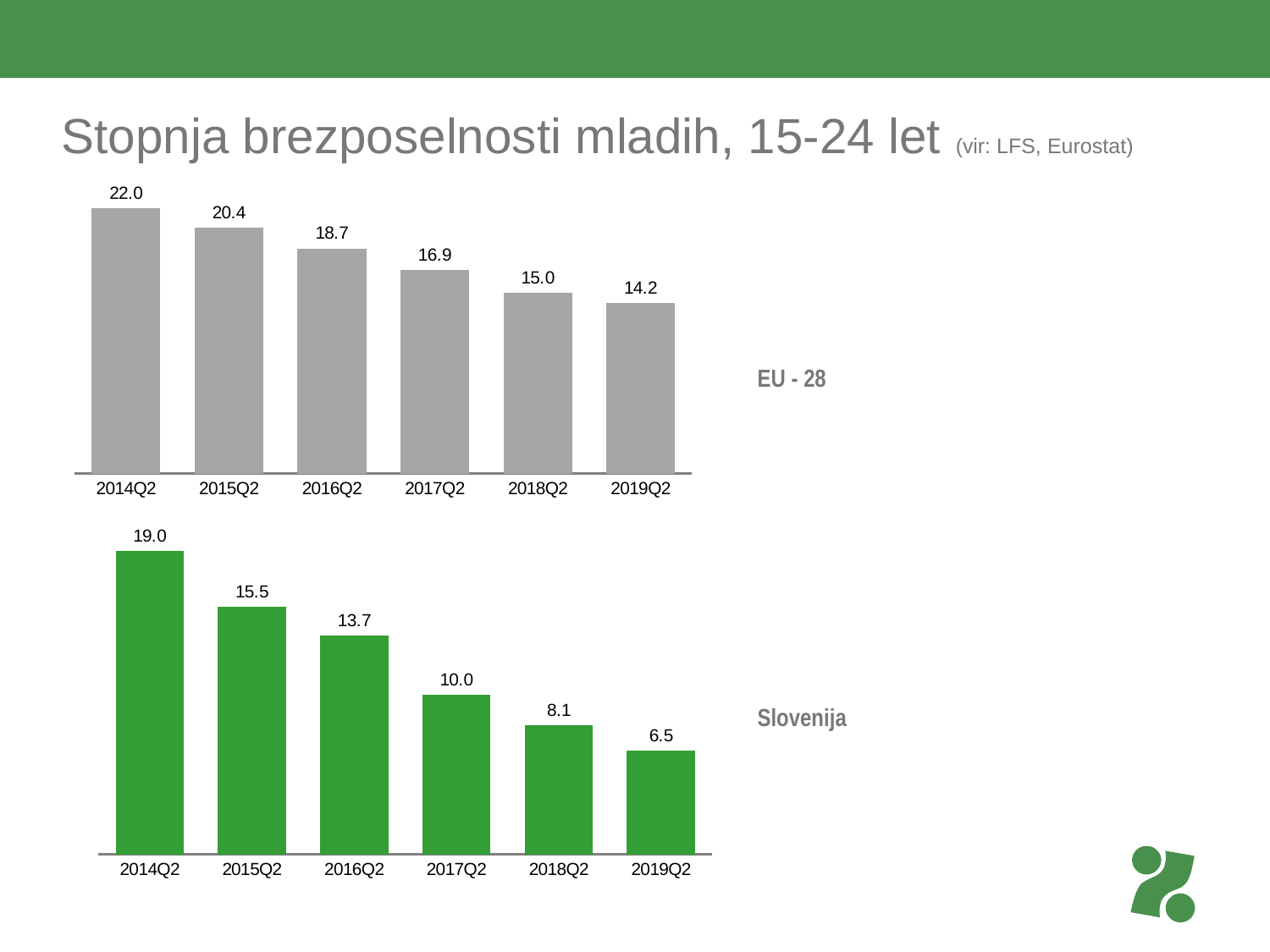
In the EU - 28 chart, what is the value for 2014Q2? 22.0 In the EU - 28 chart, what is the value for 2017Q2? 16.9 In the EU - 28 chart, what is the difference between the values for 2015Q2 and 2016Q2? 1.7 In the Slovenija chart, what is the difference between the values for 2014Q2 and 2019Q2? 12.5 For 2018Q2, which is larger: the EU - 28 value or the Slovenija value? EU - 28 In the Slovenija chart, do the values rise or fall from 2014Q2 to 2019Q2? fall In the EU - 28 chart, which quarter has the lowest value? 2019Q2 In the Slovenija chart, which quarter has the highest value? 2014Q2 How many quarters are shown in the Slovenija chart? 6 In the Slovenija chart, what is the value for 2019Q2? 6.5 What colour are the bars in the Slovenija chart? green What kind of chart is the EU - 28 chart? bar chart